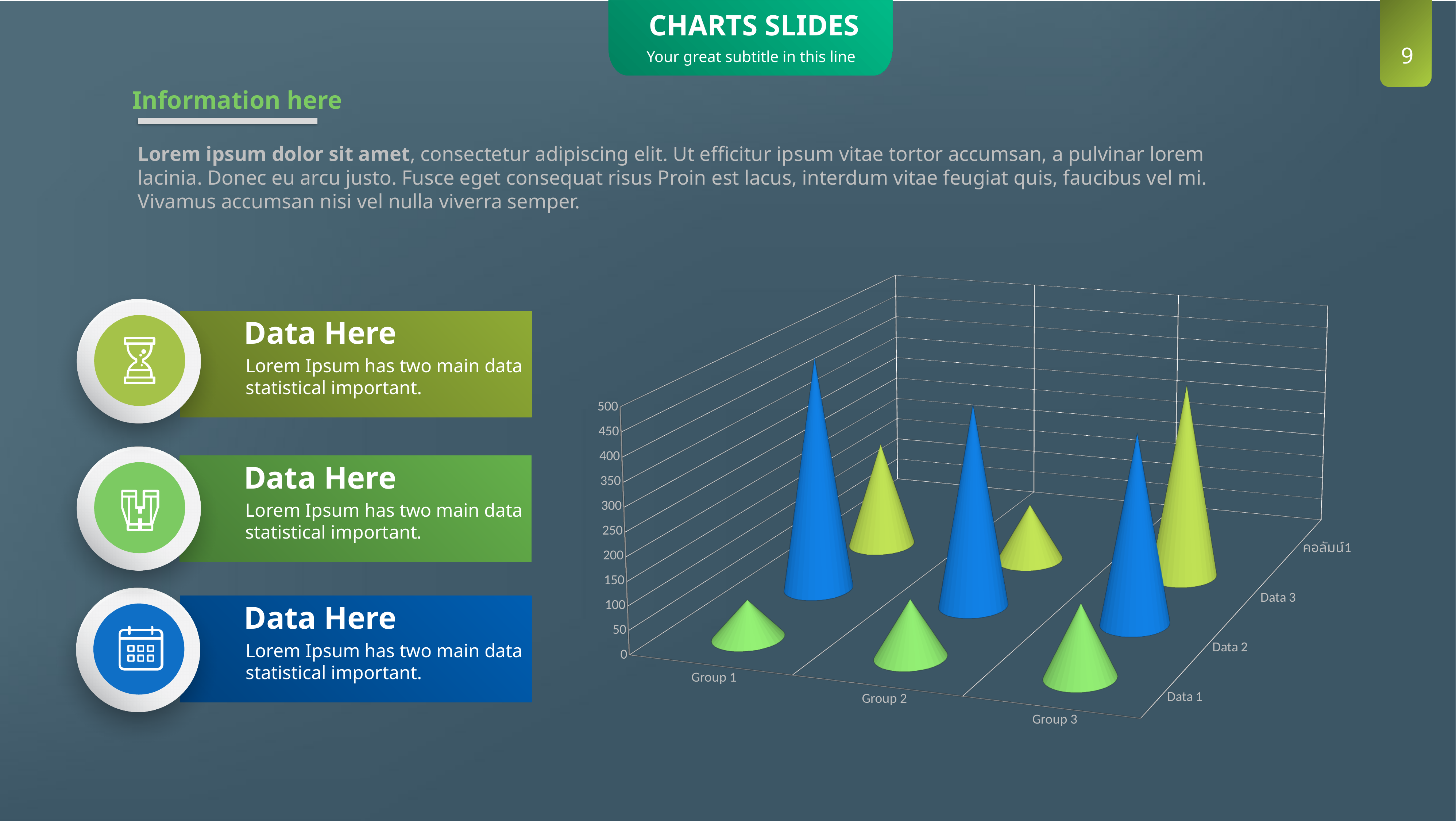
Is the value of the Data 2 cone for Group 1 greater or less than 300? greater How many groups are labelled along the horizontal axis of the chart? 3 Do the Data 1 values rise or fall from Group 1 to Group 3? rise For Group 1, which is larger: the Data 1 cone or the Data 2 cone? Data 2 Which series has the tallest cone for Group 1? Data 2 What is the interval between tick marks on the vertical axis of the chart? 50 Is the value of the Data 1 cone for Group 1 greater or less than 200? less Which group has the smallest Data 1 cone? Group 1 Is the value of the Data 3 cone for Group 2 greater or less than 400? less What kind of chart is shown on the slide? 3D cone chart What is the highest value shown on the vertical axis of the chart? 500 How many series labels appear along the depth axis of the chart? 4